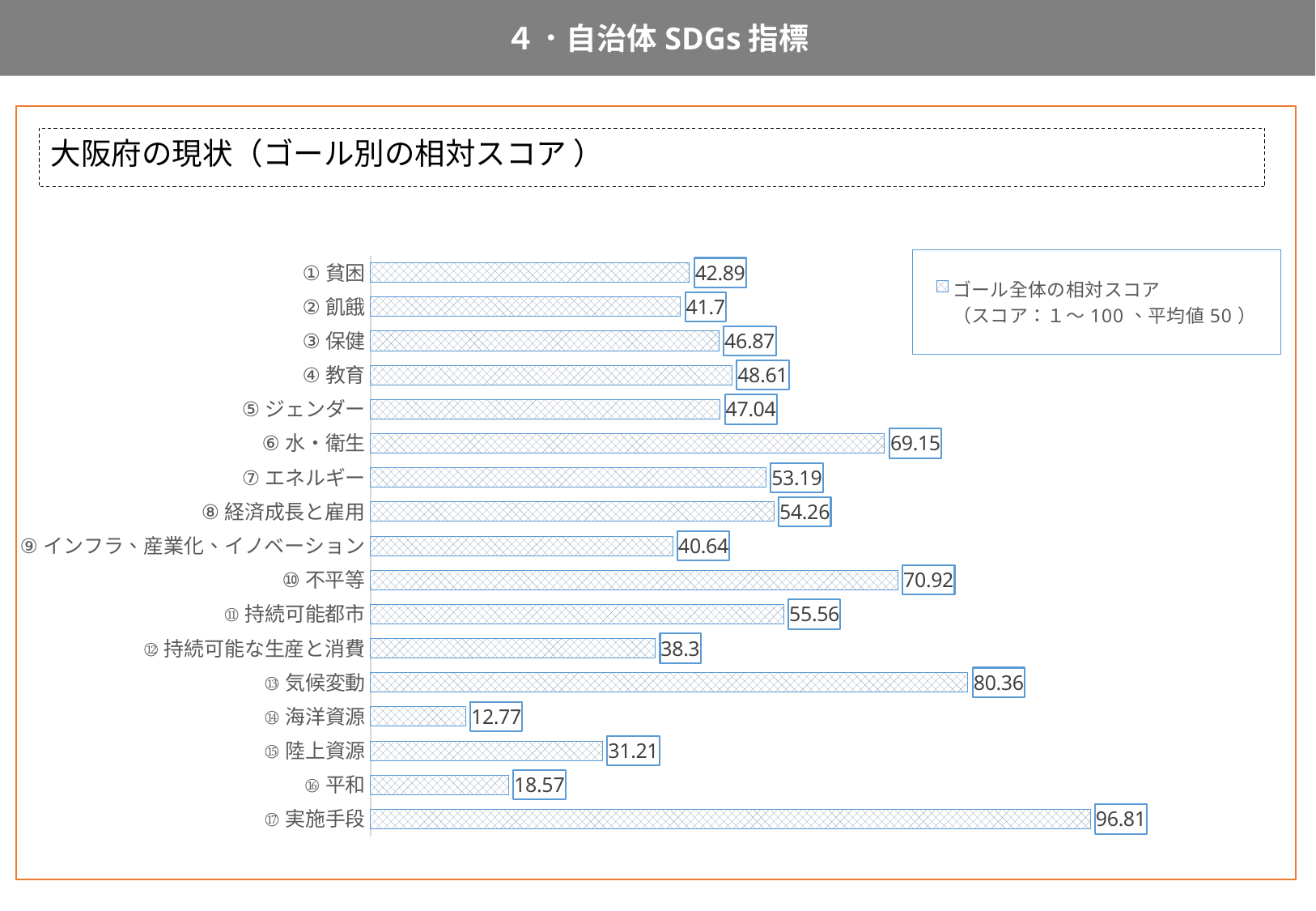
Which is larger, the value for ⑧ 経済成長と雇用 or the value for ⑦ エネルギー? ⑧ 経済成長と雇用 What is the difference between the values for ⑰ 実施手段 and ⑭ 海洋資源? 84.04 Which category has the lowest value? ⑭ 海洋資源 How many categories are shown in the chart? 17 What kind of chart is shown on the slide? bar chart What is the legend entry for the series shown in the chart? ゴール全体の相対スコア（スコア：１～100、平均値50） What is the value for ⑭ 海洋資源? 12.77 How many series does the legend list? 1 What is the value for ⑨ インフラ、産業化、イノベーション? 40.64 What is the value for ⑥ 水・衛生? 69.15 What is the difference between the values for ⑬ 気候変動 and ⑩ 不平等? 9.44 Which category has the highest value? ⑰ 実施手段